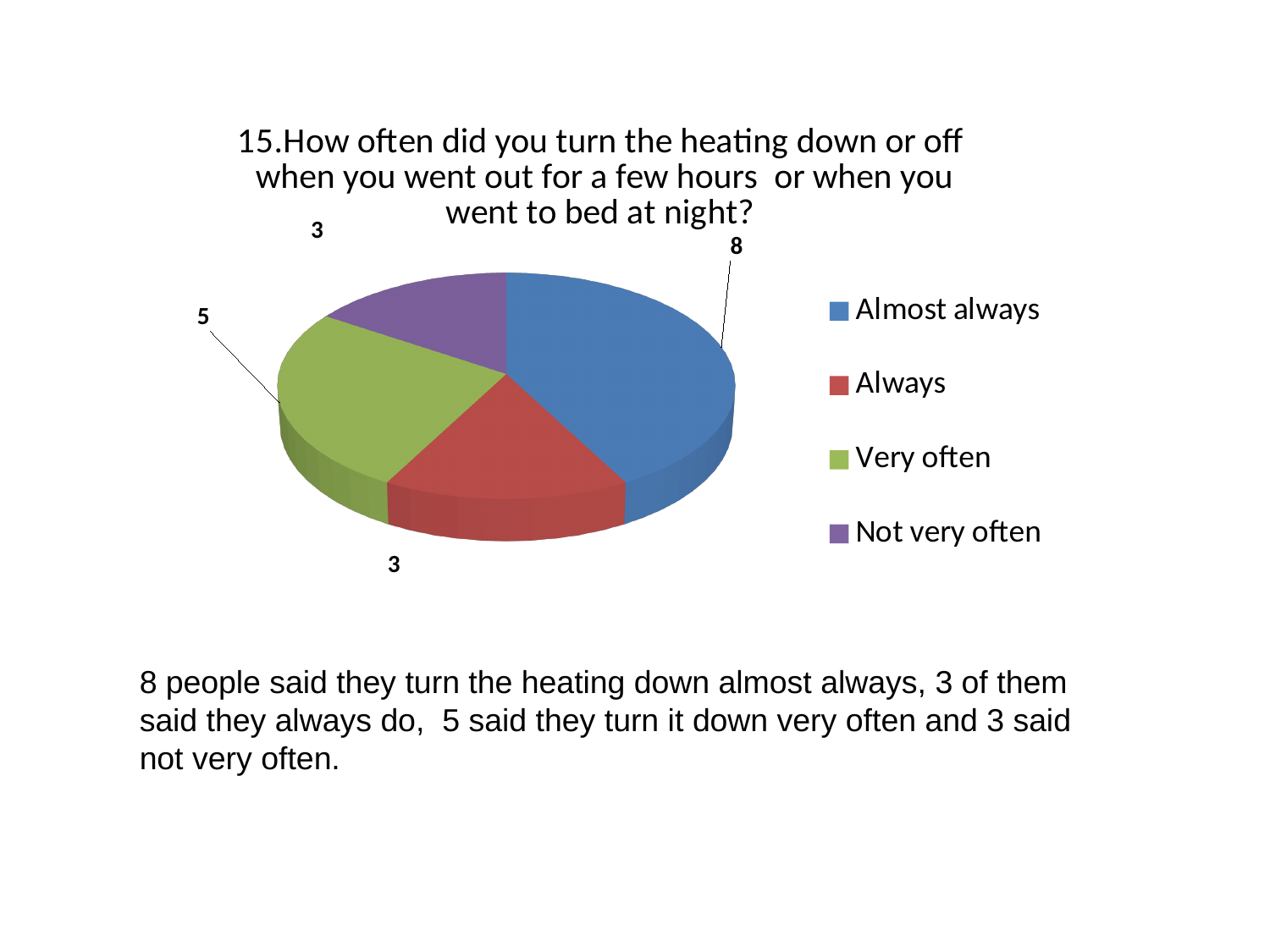
Which is larger, the value for 'Very often' or the value for 'Always'? Very often What is the total of all the values in the pie chart? 19 What is the value for 'Always'? 3 What kind of chart is shown on the slide? Pie chart Which colour represents 'Very often' in the pie chart? Green What is the difference between the values for 'Very often' and 'Not very often'? 2 What is the value for 'Not very often'? 3 What is the difference between the values for 'Almost always' and 'Very often'? 3 Which category has the largest slice of the pie? Almost always How many categories does the legend list? 4 How many people answered 'Almost always'? 8 What is the value for 'Very often'? 5